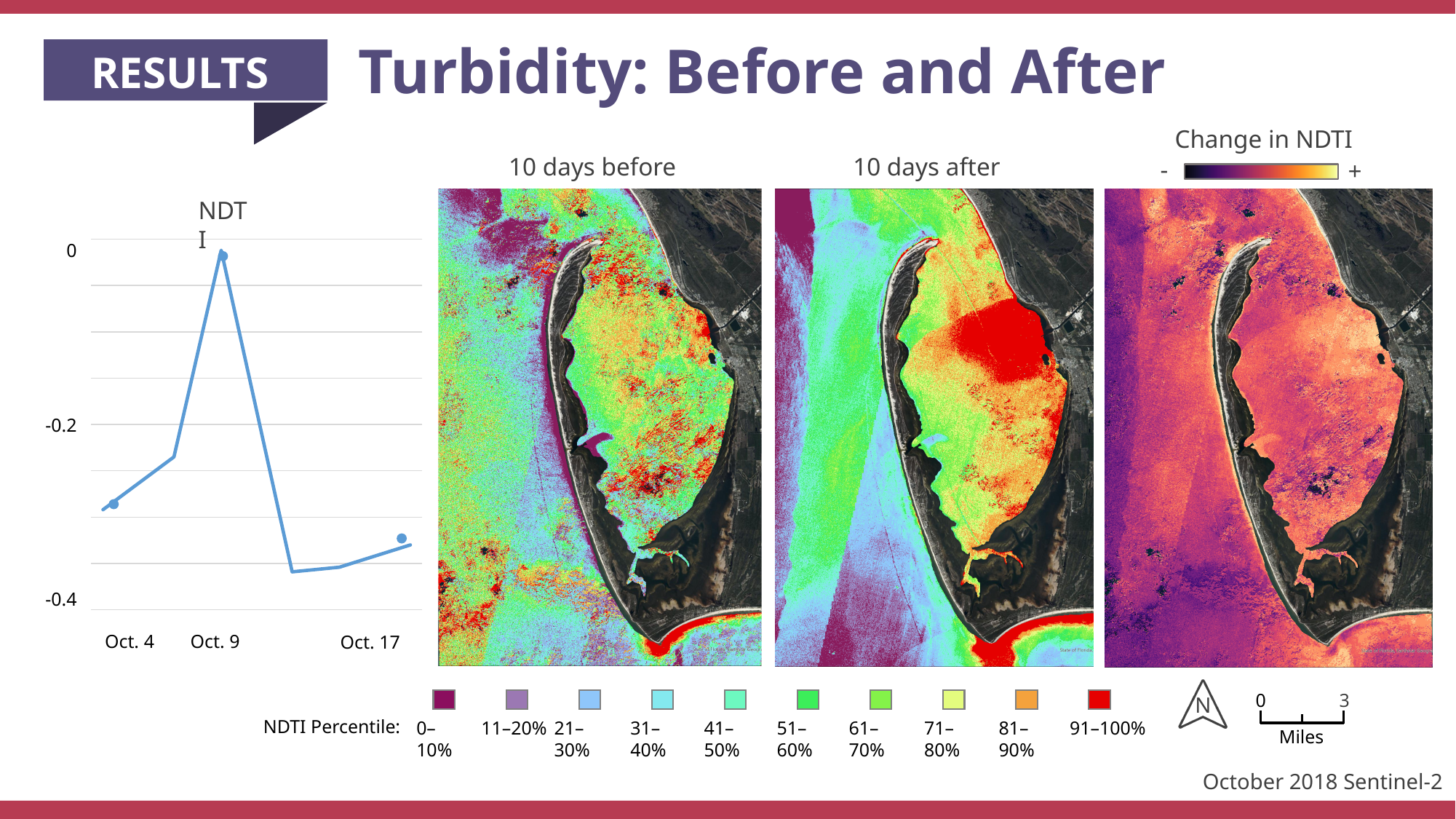
In the NDTI line chart, which labeled date has the highest value? Oct. 9 In the NDTI line chart, is the value for Oct. 9 greater or less than -0.2? greater In the NDTI line chart, does the value rise or fall from Oct. 4 to Oct. 9? rise What kind of chart is the NDTI chart on the left of the slide? line chart In the NDTI line chart, which is higher, the value for Oct. 4 or the value for Oct. 17? Oct. 4 In the NDTI line chart, is the value for Oct. 4 greater or less than -0.2? less How many dates are labeled on the x axis of the NDTI line chart? 3 What is the lowest value labeled on the y axis of the NDTI line chart? -0.4 In the NDTI line chart, does the value rise or fall from Oct. 9 to Oct. 17? fall What is the title of the line chart on the left of the slide? NDTI In the NDTI line chart, is the value for Oct. 17 greater or less than -0.4? greater